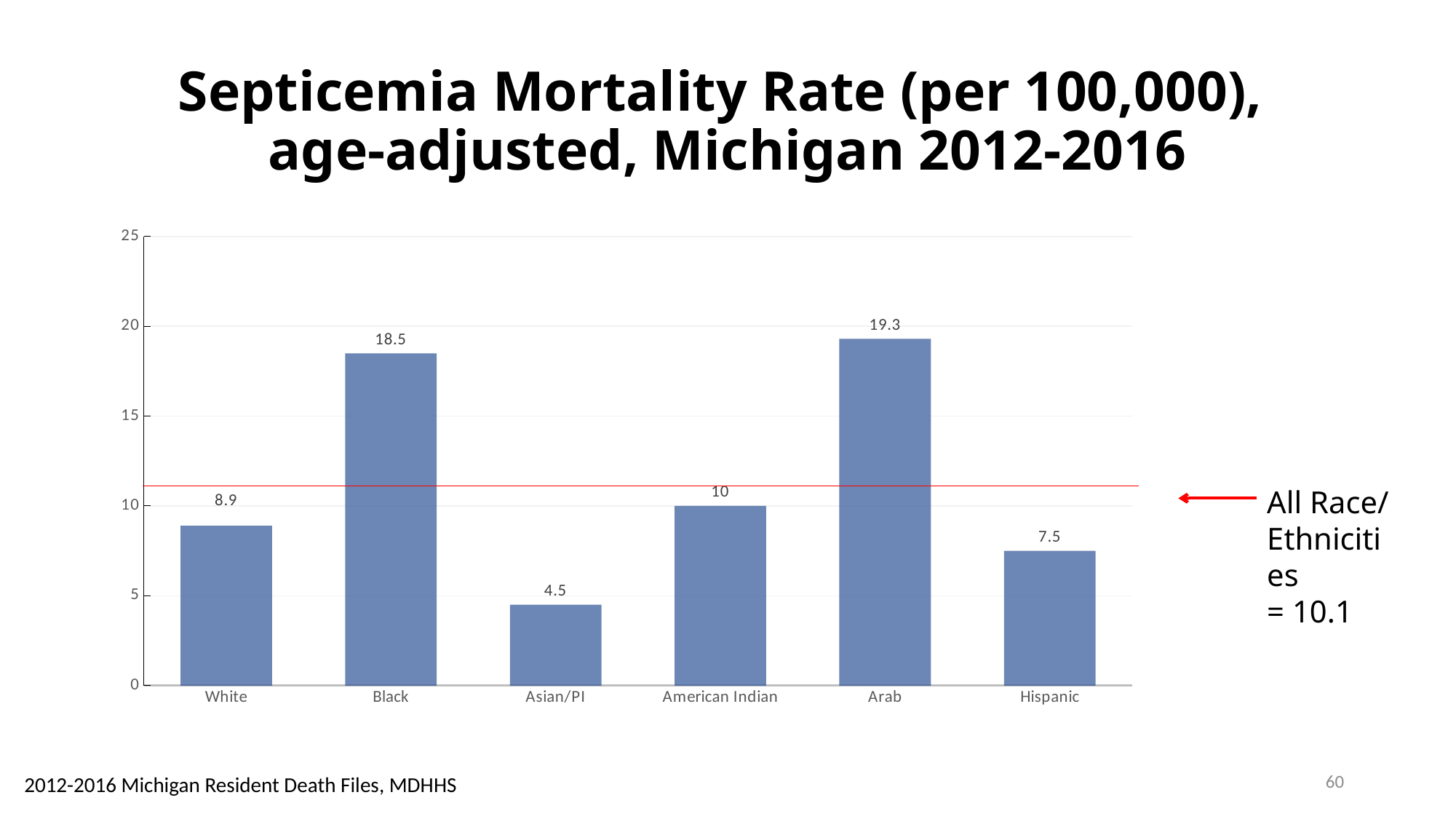
Is the value for White greater or less than 10? less Which race/ethnicity has the lowest septicemia mortality rate? Asian/PI Which race/ethnicity has the highest septicemia mortality rate? Arab What is the difference between the septicemia mortality rates for Arab and White residents? 10.4 What is the septicemia mortality rate for all race/ethnicities combined, as noted next to the chart? 10.1 What kind of chart is shown on the slide? Bar chart What is the septicemia mortality rate for Asian/PI residents? 4.5 What is the septicemia mortality rate for Hispanic residents? 7.5 How many race/ethnicity categories are shown on the chart? 6 What is the septicemia mortality rate for Black residents? 18.5 What is the difference between the septicemia mortality rates for Black and Asian/PI residents? 14 Which has a higher septicemia mortality rate, American Indian or Hispanic residents? American Indian